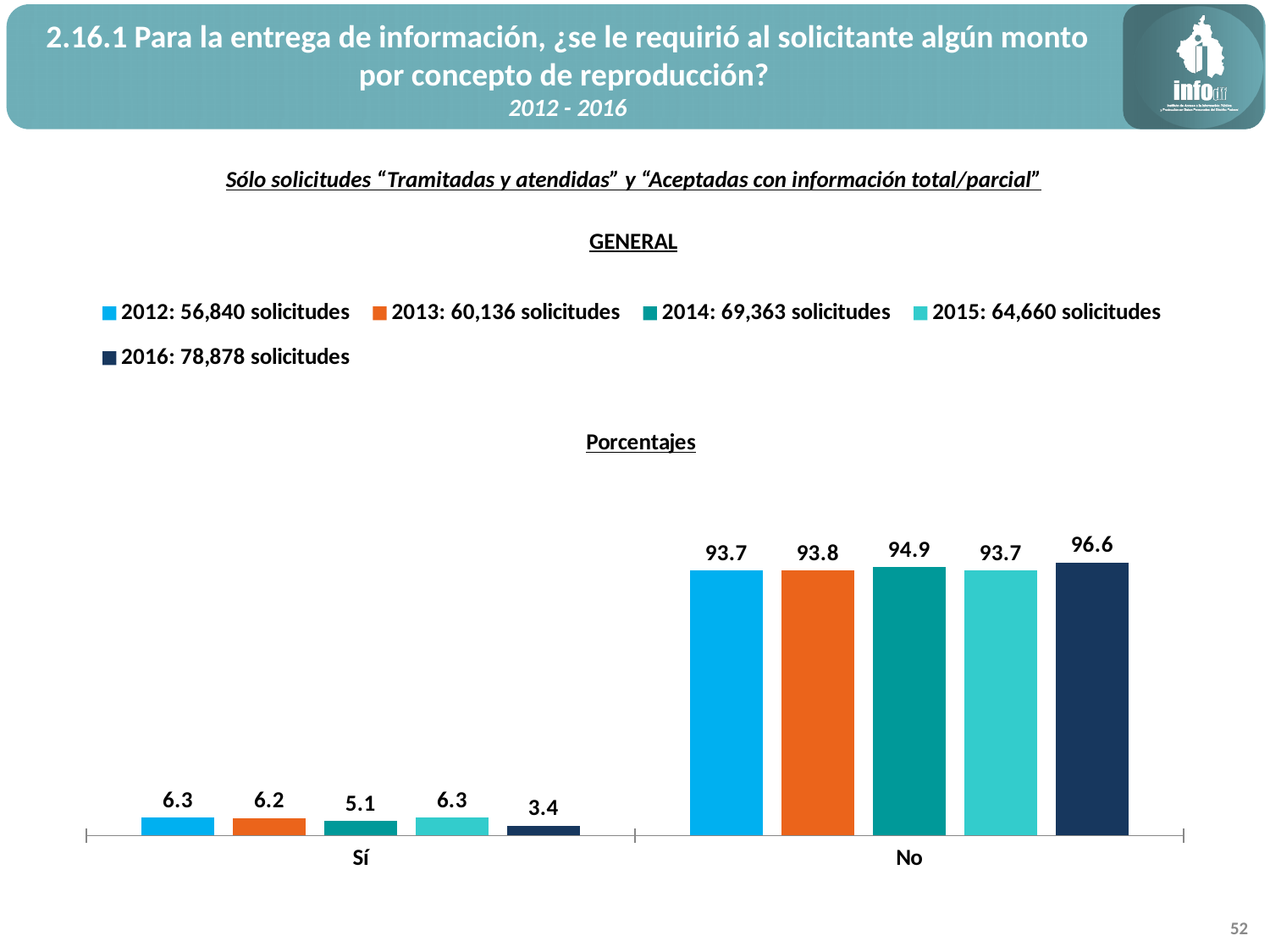
According to the legend, how many solicitudes were there in 2016? 78,878 solicitudes What kind of chart is shown on the slide? Bar chart What is the difference between the 2016 and 2012 values in the "No" category? 2.9 Which is larger in the "Sí" category: the value for 2013 or the value for 2016? 2013 What is the value for 2014 in the "Sí" category? 5.1 What is the value for 2012 in the "Sí" category? 6.3 What is the value for 2016 in the "No" category? 96.6 Which year has the lowest value in the "Sí" category? 2016 How many categories are shown on the x axis? 2 How many series does the legend list? 5 What is the difference between the 2012 and 2014 values in the "Sí" category? 1.2 Which year has the highest value in the "No" category? 2016